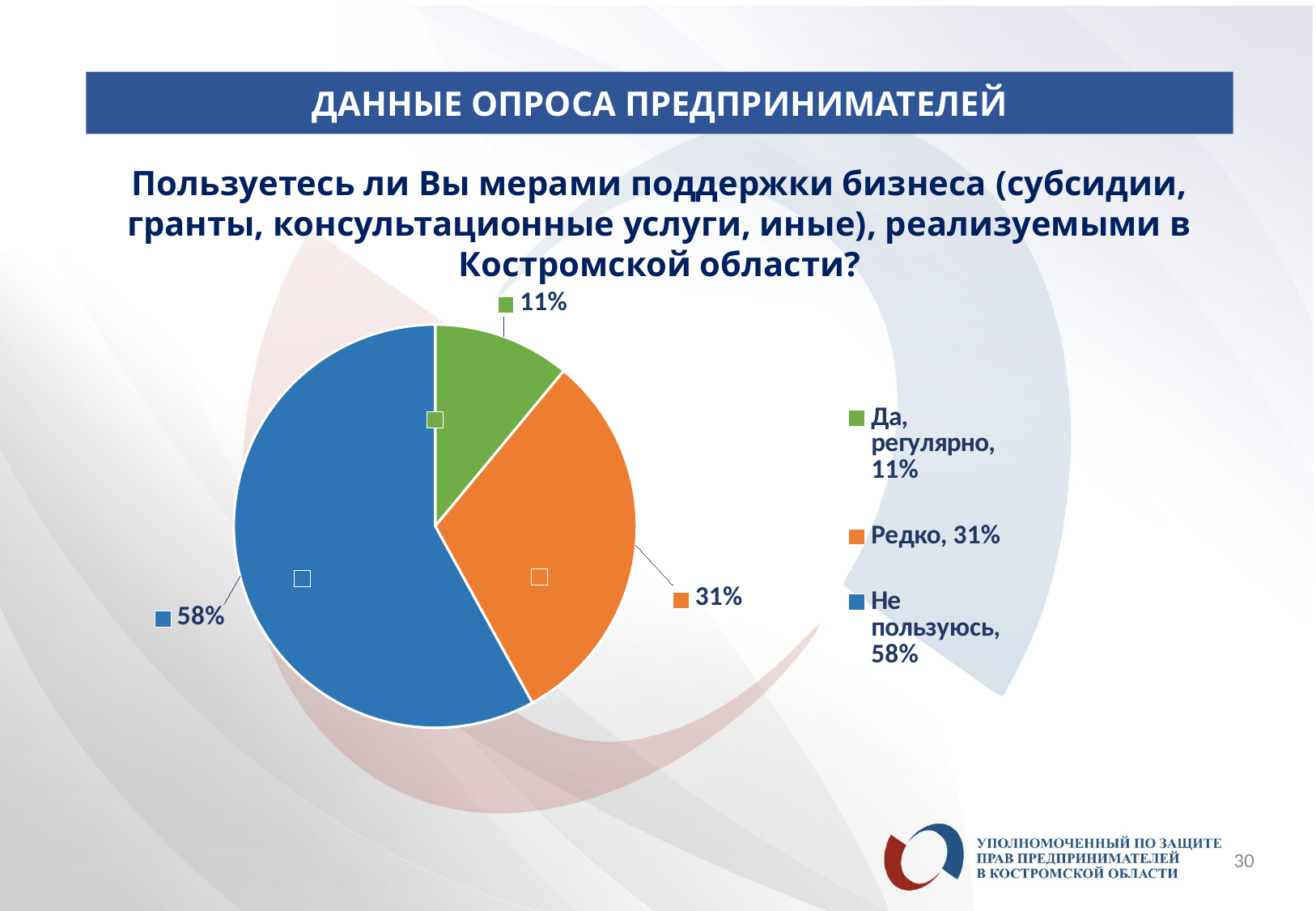
What is the difference in percentage points between "Не пользуюсь" and "Редко"? 27 Which answer has the largest share of the pie? Не пользуюсь What share of respondents answered "Не пользуюсь"? 58% What is the combined share of "Да, регулярно" and "Редко"? 42% What share of respondents answered "Редко"? 31% What share of respondents answered "Да, регулярно"? 11% What kind of chart is shown on the slide? pie chart Which is larger: the share for "Редко" or the share for "Да, регулярно"? Редко What is the difference in percentage points between "Редко" and "Да, регулярно"? 20 How many slices does the pie chart have? 3 What colour is the slice for "Не пользуюсь"? blue Which answer has the smallest share of the pie? Да, регулярно